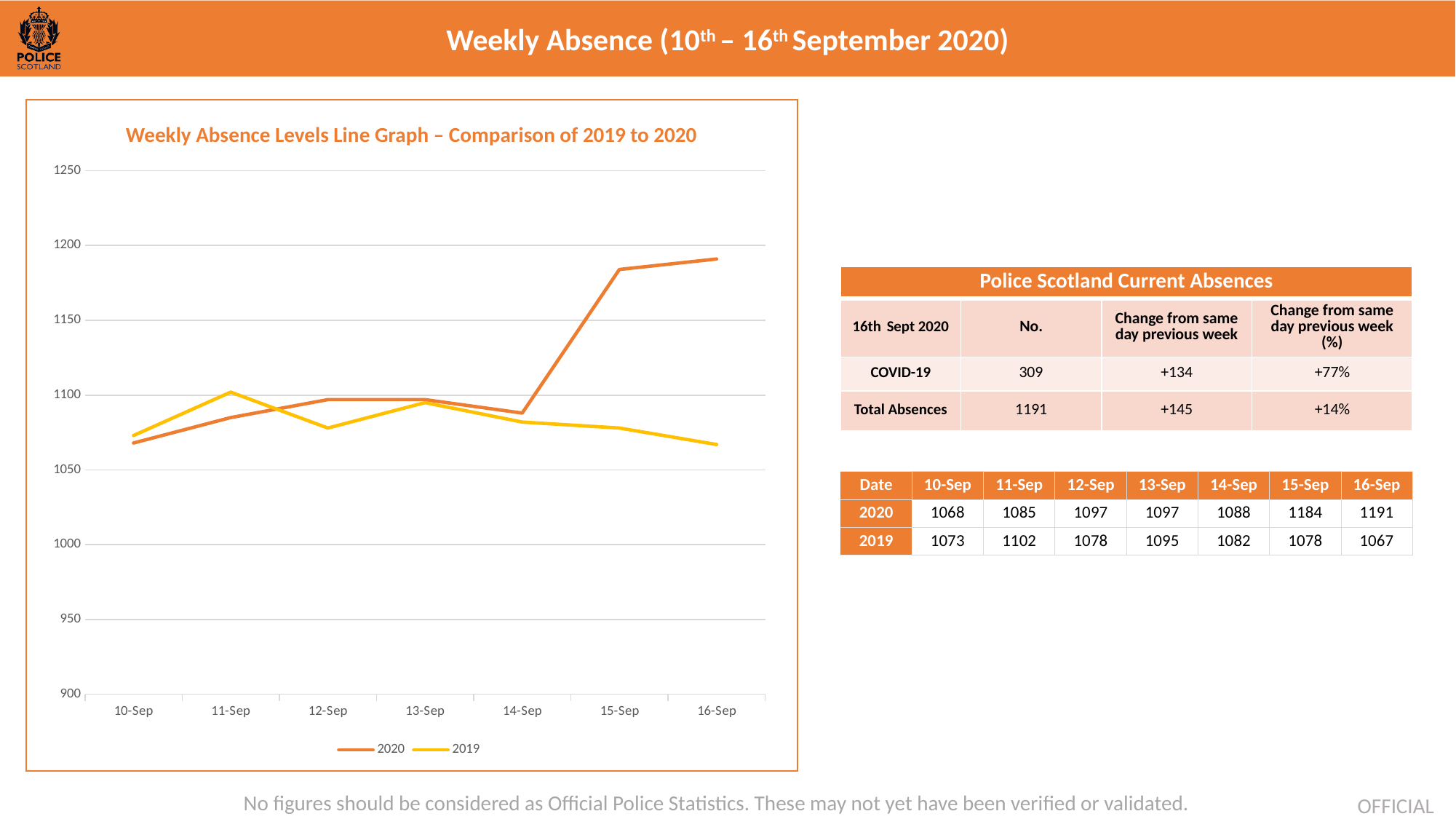
On which date is the 2019 series at its lowest? 16-Sep What type of chart is shown on the slide? Line chart What is the title of the line chart? Weekly Absence Levels Line Graph – Comparison of 2019 to 2020 On 11-Sep, which series has the higher value, 2020 or 2019? 2019 How many series does the chart legend list? 2 On which date is the 2020 series at its highest? 16-Sep Is the 2020 value on 15-Sep greater or less than 1150? greater How many dates are plotted along the x axis of the line chart? 7 What is the 2019 absence value on 11-Sep? 1102 What is the difference between the 2020 and 2019 values on 16-Sep? 124 What is the 2020 absence value on 16-Sep? 1191 Does the 2019 series rise or fall between 13-Sep and 16-Sep? Falls